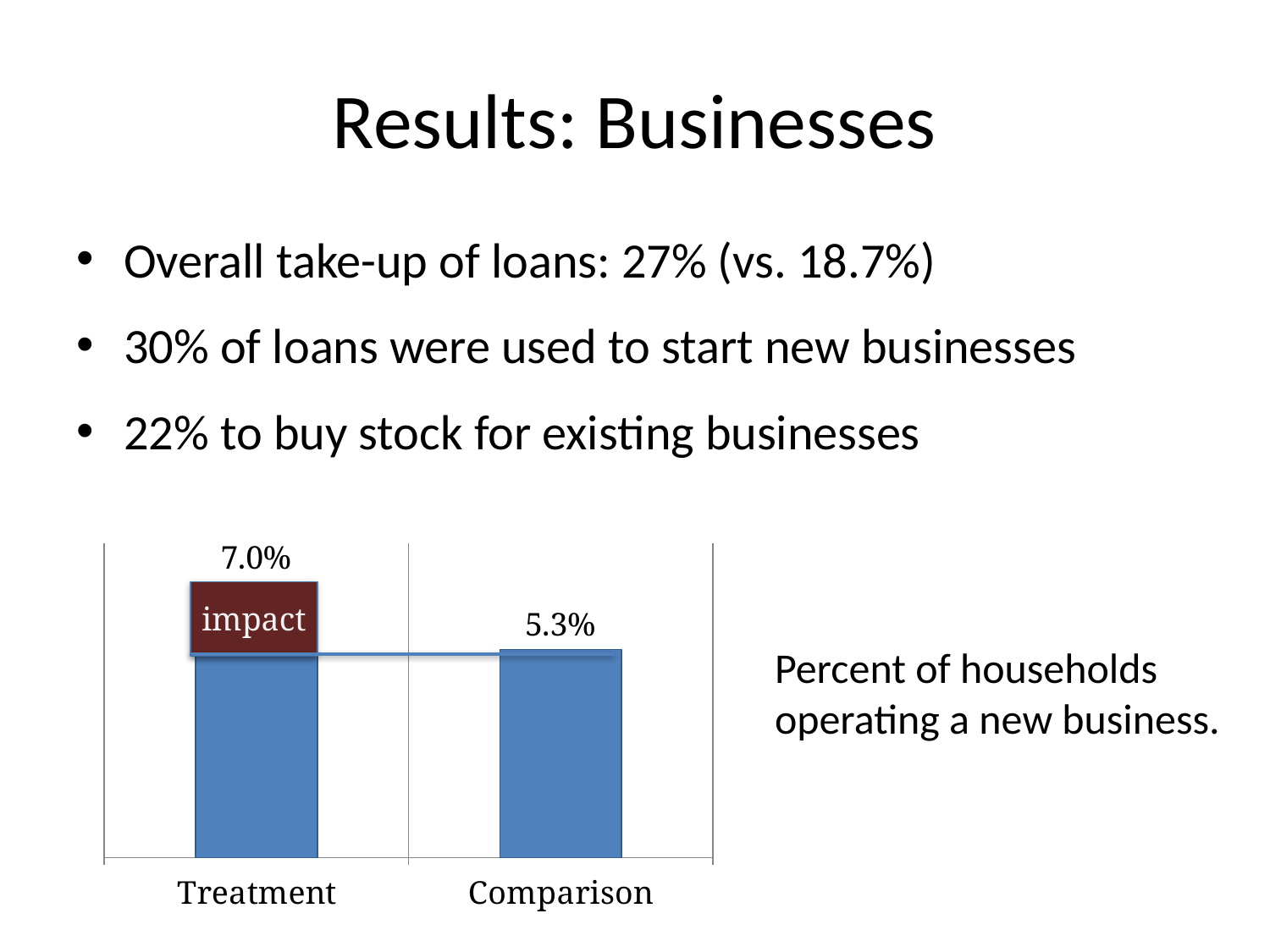
Which category has the highest value? Treatment What label is written on the dark red box above the Treatment bar? impact What kind of chart is shown on the slide? Bar chart What is the difference between the Treatment and Comparison values? 1.7% Which is larger, the value for Treatment or the value for Comparison? Treatment What is the value for Treatment? 7.0% Which category has the lowest value? Comparison What is the value for Comparison? 5.3% According to the text next to the chart, what does the chart show? Percent of households operating a new business. How many categories are shown on the x axis? 2